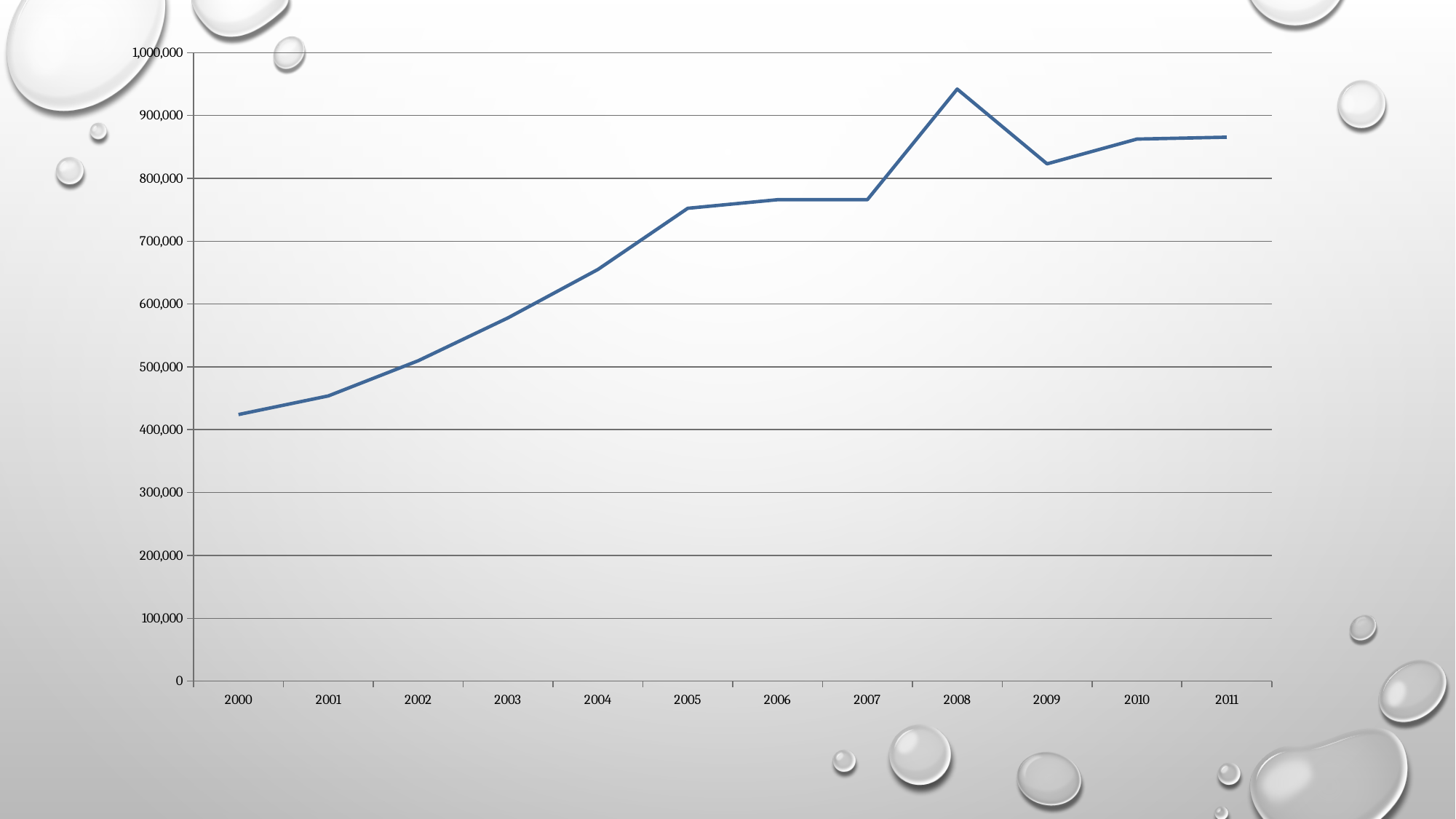
Is the value for 2009 greater or less than 900,000? less Do the values rise or fall from 2000 to 2005? rise Is the value for 2000 greater or less than 500,000? less Which year has the larger value, 2008 or 2009? 2008 Which year has the lowest value? 2000 How many years are plotted along the x axis? 12 Do the values rise or fall from 2008 to 2009? fall Is the value for 2005 greater or less than 700,000? greater What kind of chart is shown on the slide? line chart Which year has the larger value, 2004 or 2005? 2005 Which year has the highest value? 2008